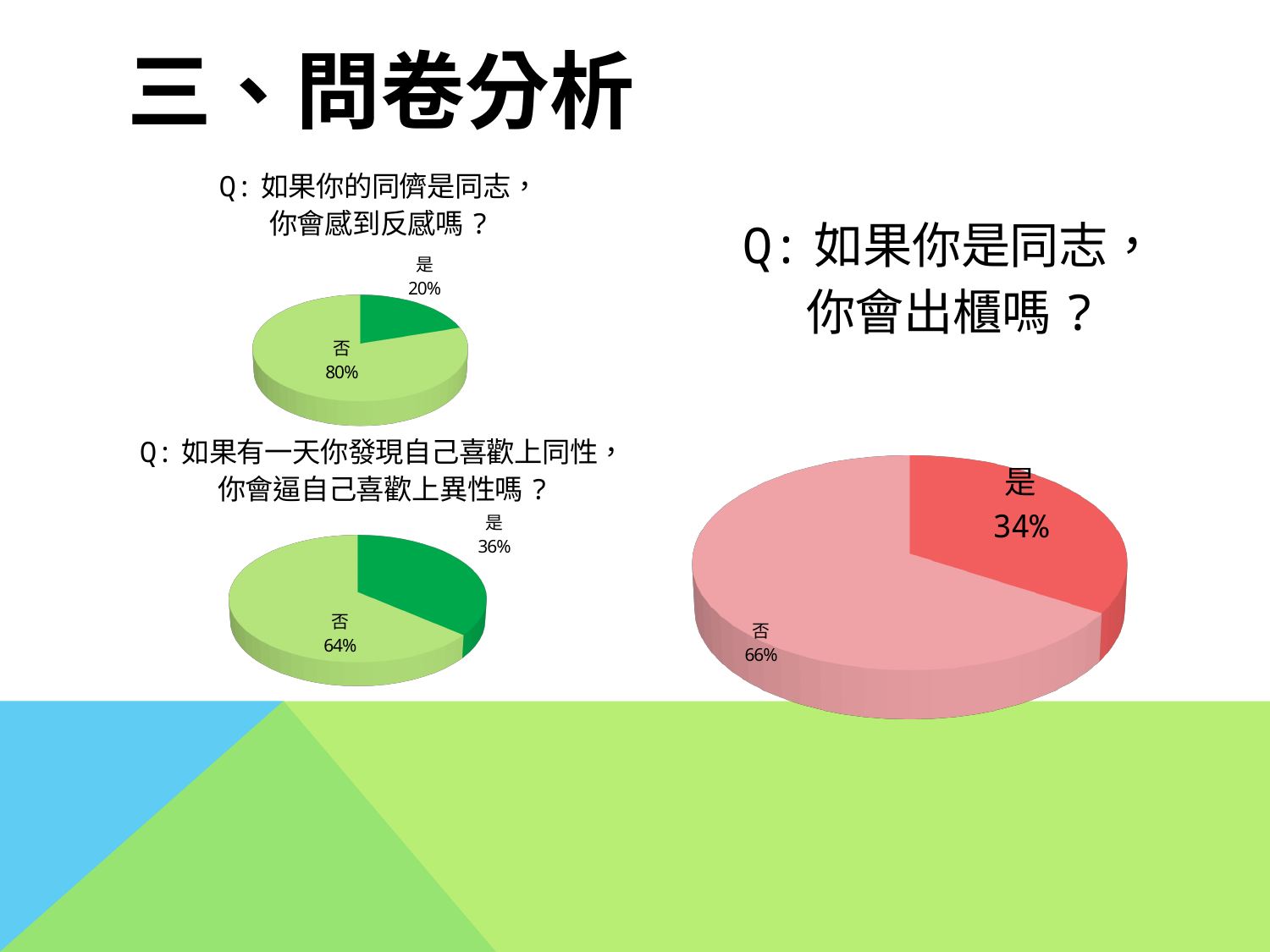
In the bottom-left pie chart (你會逼自己喜歡上異性嗎？), what is the difference between the 否 and 是 percentages? 28% In the right-hand pie chart (如果你是同志，你會出櫃嗎？), how many slices does the pie have? 2 In the top-left pie chart (如果你的同儕是同志，你會感到反感嗎？), what share of respondents answered 是? 20% In the right-hand pie chart (如果你是同志，你會出櫃嗎？), which answer has the larger slice? 否 In the bottom-left pie chart (你會逼自己喜歡上異性嗎？), what percentage is shown for 是? 36% In the right-hand pie chart (如果你是同志，你會出櫃嗎？), what share answered 是? 34% In the top-left pie chart (如果你的同儕是同志，你會感到反感嗎？), which answer has the smallest slice? 是 In the bottom-left pie chart (你會逼自己喜歡上異性嗎？), what percentage is shown for 否? 64% In the right-hand pie chart (如果你是同志，你會出櫃嗎？), what share answered 否? 66% In the top-left pie chart (如果你的同儕是同志，你會感到反感嗎？), what share of respondents answered 否? 80% What type of chart is used for the question 如果你是同志，你會出櫃嗎？? Pie chart How many pie charts are shown on the slide? 3